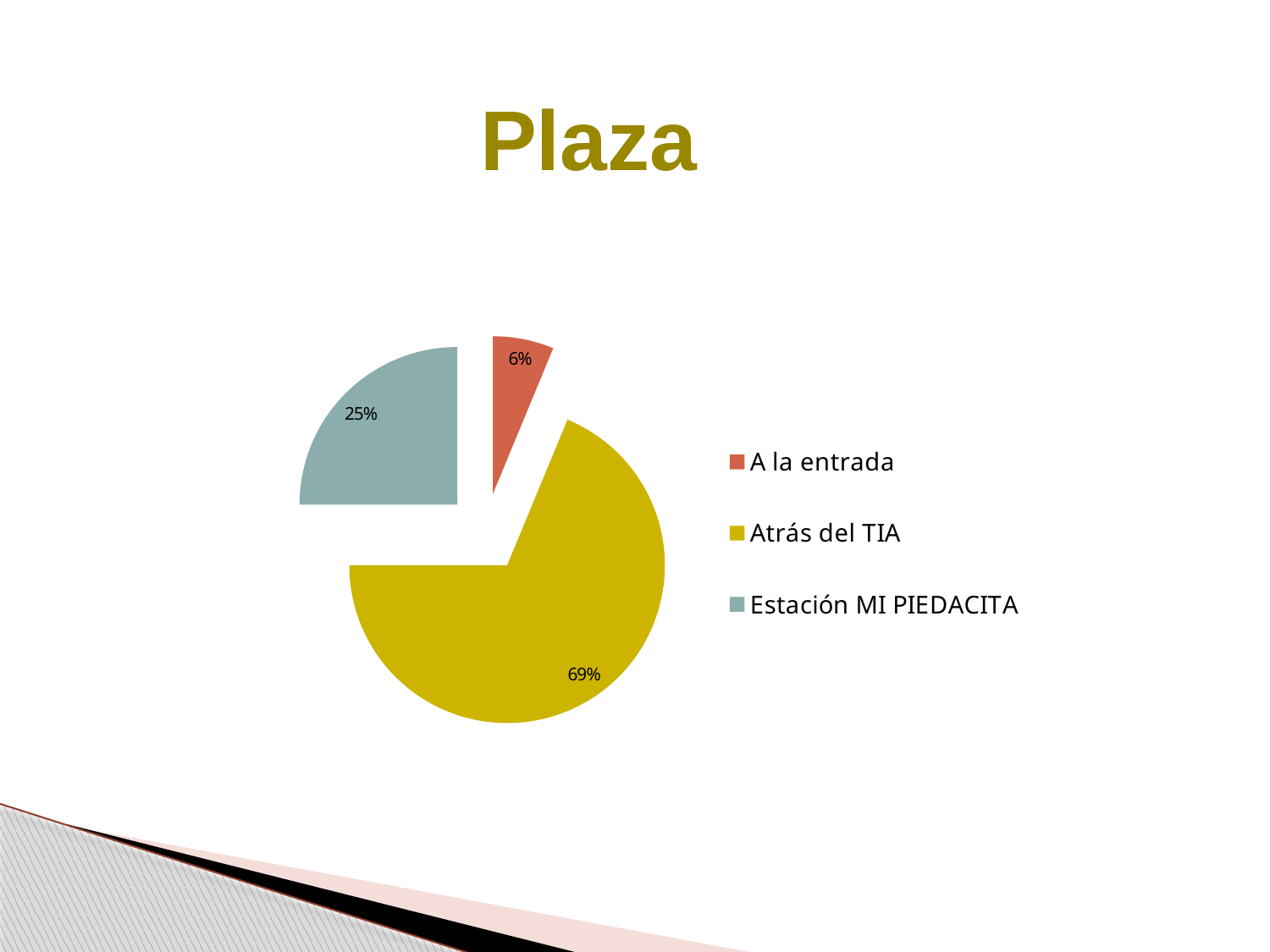
Which is larger, the slice for "Estación MI PIEDACITA" or the slice for "A la entrada"? Estación MI PIEDACITA What kind of chart is shown on the slide? pie chart Which category has the smallest slice of the pie? A la entrada What share of the pie does "A la entrada" have? 6% How many entries does the legend list? 3 What colour is the slice for "A la entrada"? red/orange What share of the pie does "Atrás del TIA" have? 69% How many slices does the pie chart have? 3 What is the difference in percentage points between "Atrás del TIA" and "Estación MI PIEDACITA"? 44 What is the title shown above the chart? Plaza What share of the pie does "Estación MI PIEDACITA" have? 25% Which category has the largest slice of the pie? Atrás del TIA